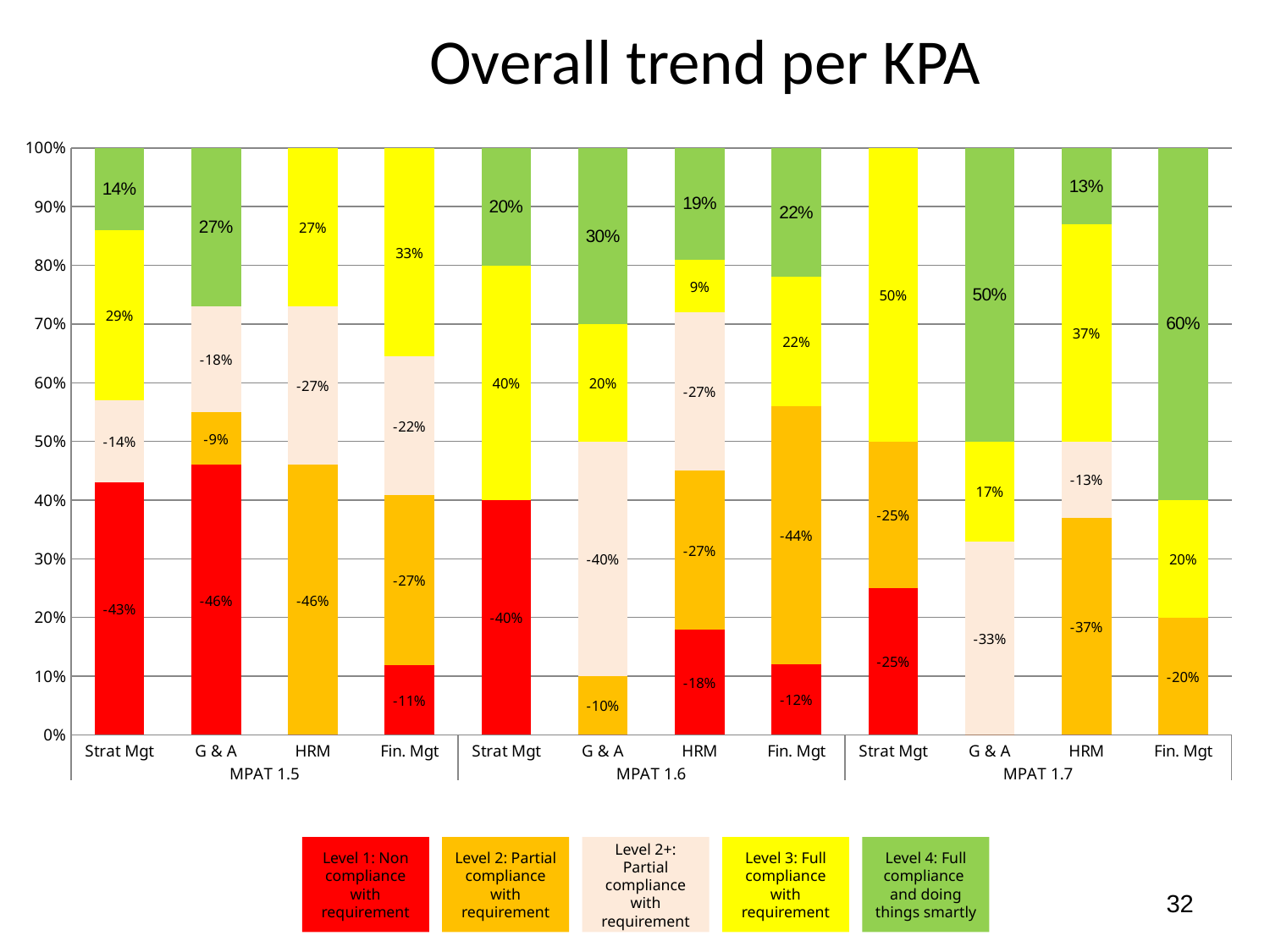
What is the Level 3 (yellow) value for Strat Mgt under MPAT 1.7? 50% What is the Level 2+ (light) value printed for G & A under MPAT 1.6? -40% What is the difference between the Level 4 (green) values for Fin. Mgt and G & A under MPAT 1.7? 10% Which bar has the largest Level 4 (green) segment? Fin. Mgt (MPAT 1.7) Under MPAT 1.6, which has the larger Level 4 (green) value: Strat Mgt or G & A? G & A What type of chart is shown on the slide? Stacked bar chart What is the Level 4 (green) value for Fin. Mgt under MPAT 1.7? 60% How many series does the legend list? 5 How many bars are plotted in the chart? 12 What is the title of the chart? Overall trend per KPA What is the Level 4 (green) value for HRM under MPAT 1.6? 19% What is the Level 1 (red) value printed for Strat Mgt under MPAT 1.5? -43%